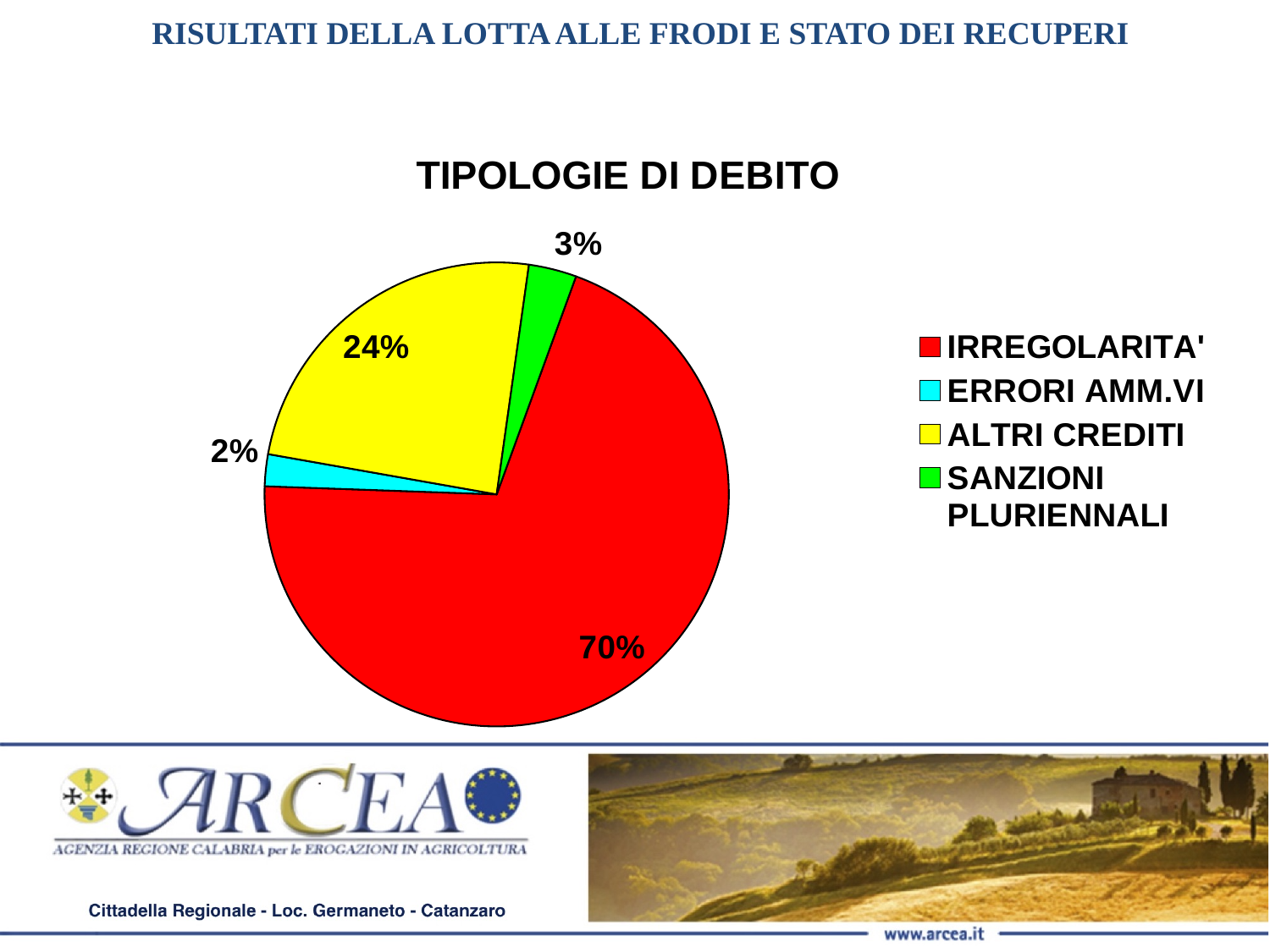
What is the difference in percentage points between IRREGOLARITA' and ALTRI CREDITI? 46 What kind of chart is shown on the slide? Pie chart What share of the pie does IRREGOLARITA' represent? 70% Which category has the largest slice of the pie? IRREGOLARITA' How many categories does the pie chart show? 4 Which category has the smallest slice of the pie? ERRORI AMM.VI What colour is the slice for ALTRI CREDITI? Yellow What share of the pie does SANZIONI PLURIENNALI represent? 3% What share of the pie does ALTRI CREDITI represent? 24% What is the title of the chart? TIPOLOGIE DI DEBITO Which is larger, the share for ALTRI CREDITI or the share for SANZIONI PLURIENNALI? ALTRI CREDITI